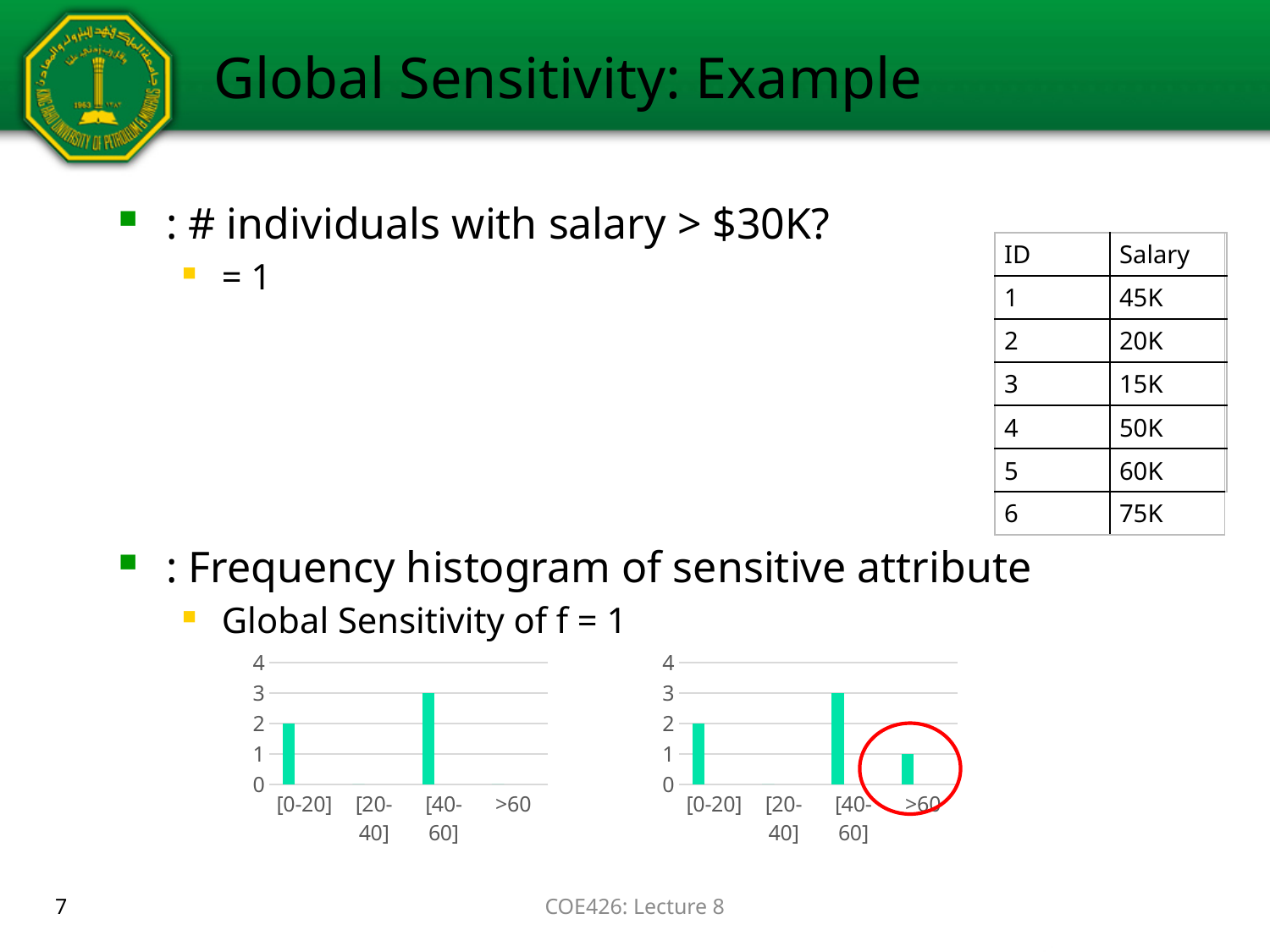
In the left chart, what is the value for the [0-20] category? 2 What kind of chart is the right chart? bar chart In the right chart, which is larger, the value for [0-20] or the value for >60? [0-20] How many categories are shown on the x axis of the left chart? 4 In the left chart, is the value for [40-60] greater or less than 2? greater In the right chart, which category has the highest value? [40-60] In the left chart, which category has the highest value? [40-60] In the right chart, what is the value for the >60 category? 1 Which category in the right chart is circled in red? >60 In the right chart, what is the difference between the values for [40-60] and [0-20]? 1 In the left chart, what is the value for the [40-60] category? 3 In the right chart, what is the value for the [40-60] category? 3